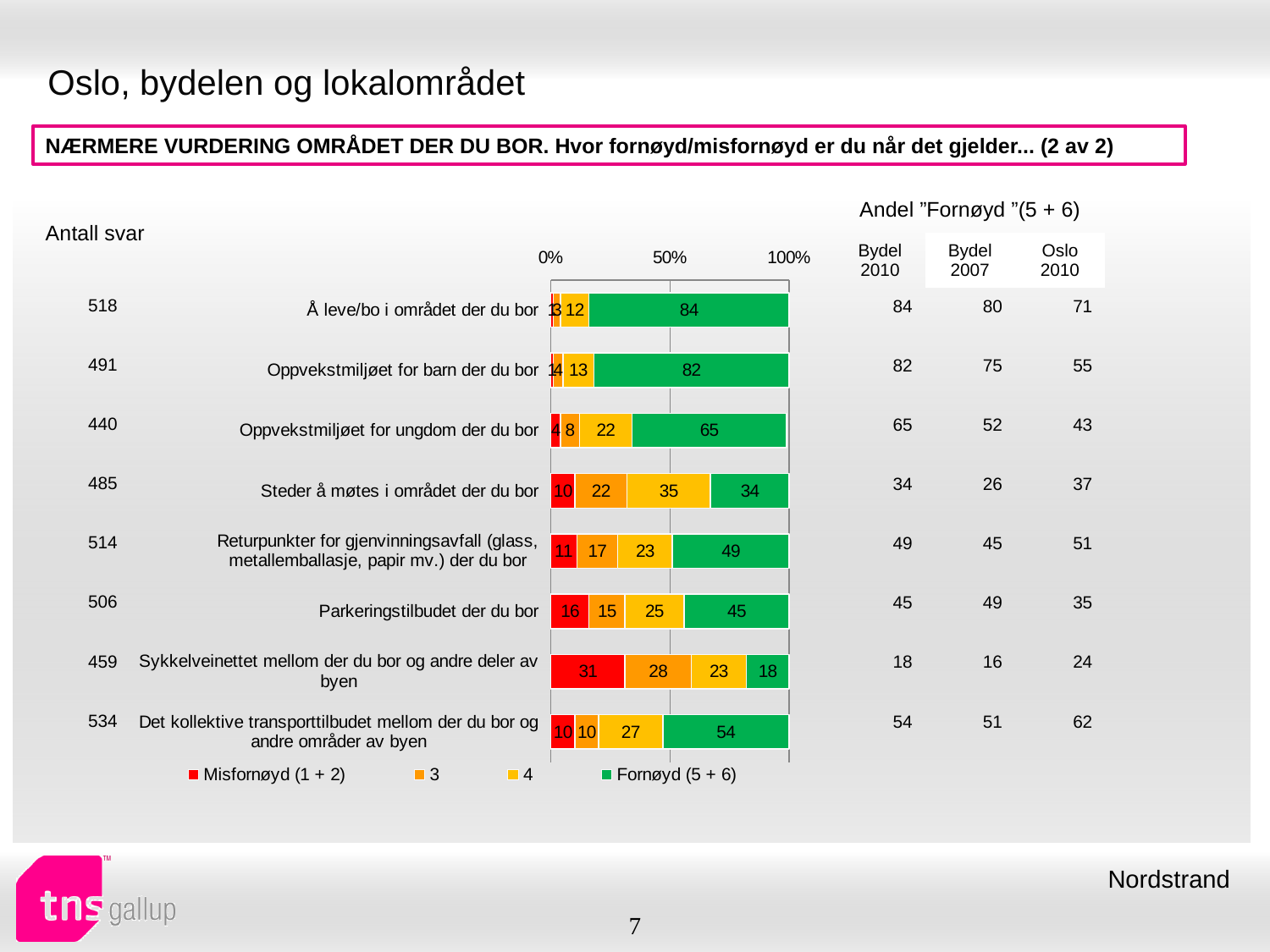
What is the value of the Misfornøyd (1 + 2) segment for "Sykkelveinettet mellom der du bor og andre deler av byen"? 31 Which category has the lowest Fornøyd (5 + 6) value? Sykkelveinettet mellom der du bor og andre deler av byen Which category has the highest Fornøyd (5 + 6) value? Å leve/bo i området der du bor How many categories are shown in the chart? 8 Which colour represents the Fornøyd (5 + 6) series in the chart? Green What kind of chart is shown on the slide? Stacked bar chart What is the value of the Fornøyd (5 + 6) segment for "Det kollektive transporttilbudet mellom der du bor og andre områder av byen"? 54 What is the difference between the Fornøyd (5 + 6) values for "Oppvekstmiljøet for ungdom der du bor" and "Parkeringstilbudet der du bor"? 20 What is the value of the "4" segment for "Steder å møtes i området der du bor"? 35 How many series does the legend list? 4 Which has a larger Misfornøyd (1 + 2) value: "Parkeringstilbudet der du bor" or "Returpunkter for gjenvinningsavfall (glass, metallemballasje, papir mv.) der du bor"? Parkeringstilbudet der du bor What is the value of the Fornøyd (5 + 6) segment for "Å leve/bo i området der du bor"? 84